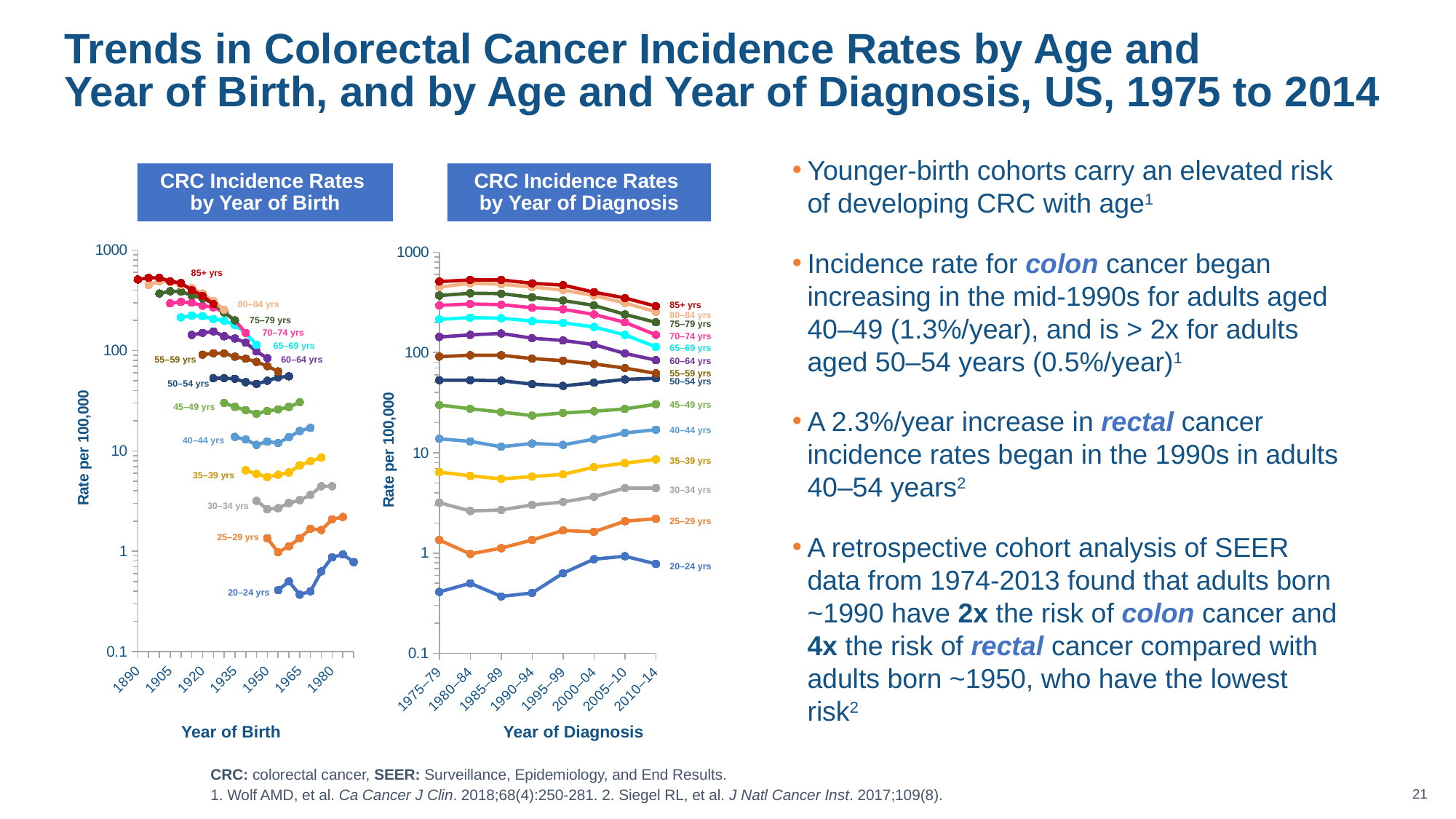
In the 'CRC Incidence Rates by Year of Diagnosis' chart, is the value for 20–24 yrs in 1975–79 greater or less than 1? less In the 'CRC Incidence Rates by Year of Diagnosis' chart, is the value for 45–49 yrs in 2010–14 greater or less than 10? greater What kind of chart is the 'CRC Incidence Rates by Year of Diagnosis' chart? Line chart In the 'CRC Incidence Rates by Year of Diagnosis' chart, in 2010–14, which is larger: the value for 45–49 yrs or for 40–44 yrs? 45–49 yrs In the 'CRC Incidence Rates by Year of Diagnosis' chart, which age group has the lowest incidence rates? 20–24 yrs In the 'CRC Incidence Rates by Year of Diagnosis' chart, does the 85+ yrs line rise or fall from 1975–79 to 2010–14? fall In the 'CRC Incidence Rates by Year of Diagnosis' chart, which age group has the highest incidence rates? 85+ yrs What is the y-axis label of the 'CRC Incidence Rates by Year of Birth' chart? Rate per 100,000 In the 'CRC Incidence Rates by Year of Diagnosis' chart, how many year-of-diagnosis periods are shown on the x axis? 8 In the 'CRC Incidence Rates by Year of Diagnosis' chart, how many age-group series are plotted? 14 In the 'CRC Incidence Rates by Year of Diagnosis' chart, is the value for 85+ yrs in 1975–79 greater or less than 100? greater